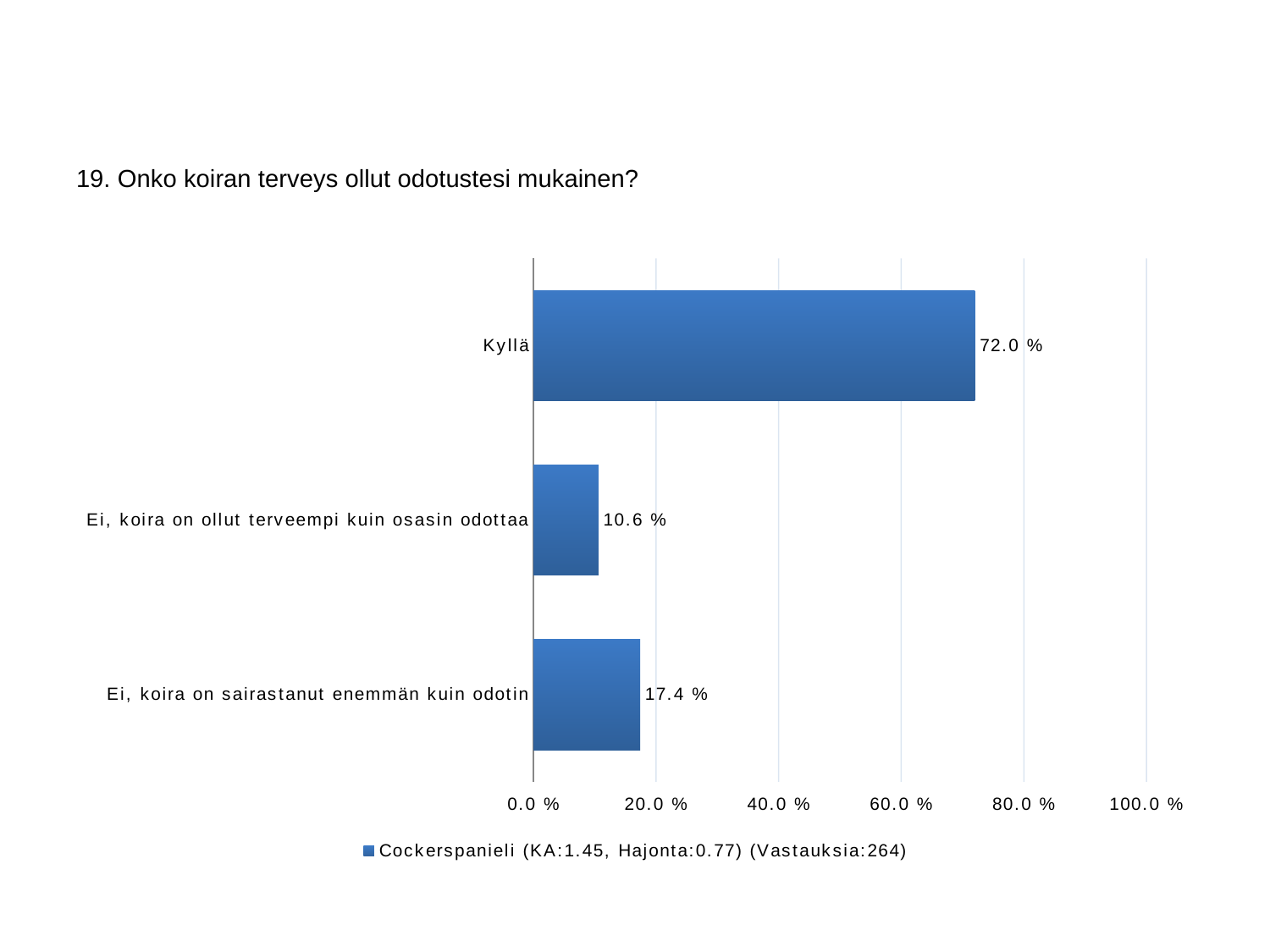
What is the value for "Kyllä"? 72.0 % Is the value for "Kyllä" greater or less than 60.0 %? greater What is the value for "Ei, koira on ollut terveempi kuin osasin odottaa"? 10.6 % How many categories are shown in the chart? 3 How many responses (Vastauksia) does the legend report? 264 Which category has the highest value? Kyllä What is the value for "Ei, koira on sairastanut enemmän kuin odotin"? 17.4 % Which is larger: the value for "Ei, koira on sairastanut enemmän kuin odotin" or "Ei, koira on ollut terveempi kuin osasin odottaa"? Ei, koira on sairastanut enemmän kuin odotin What is the difference between the values for "Kyllä" and "Ei, koira on sairastanut enemmän kuin odotin"? 54.6 % Which category has the lowest value? Ei, koira on ollut terveempi kuin osasin odottaa What kind of chart is shown on the slide? bar chart What is the difference between the values for "Ei, koira on sairastanut enemmän kuin odotin" and "Ei, koira on ollut terveempi kuin osasin odottaa"? 6.8 %